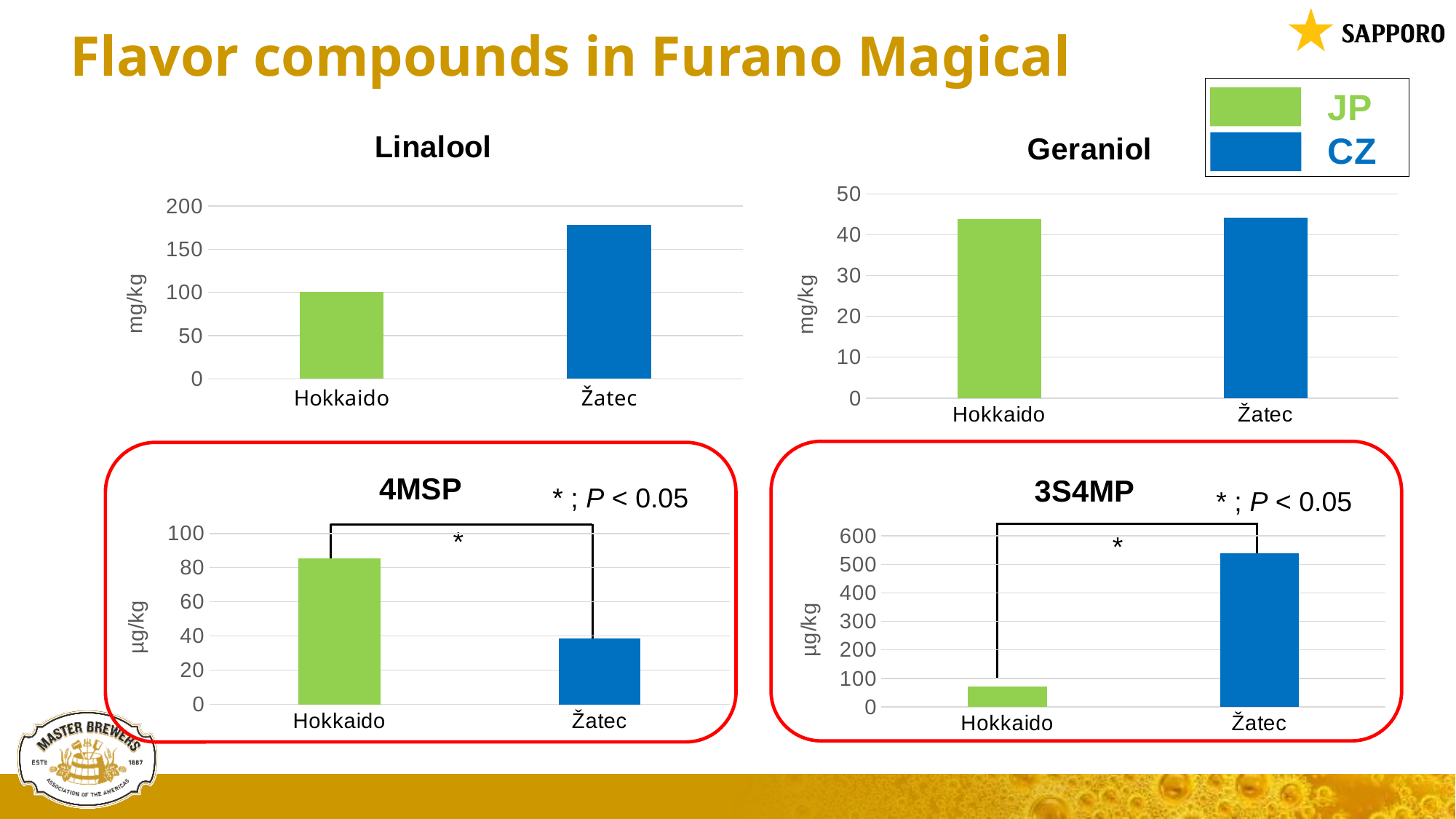
In the Linalool chart, which category has the higher value, Hokkaido or Žatec? Žatec In the Linalool chart, is the value for Žatec greater or less than 150? greater In the Geraniol chart, is the value for Hokkaido greater or less than 40? greater How many entries does the legend at the top right of the slide list? 2 In the 3S4MP chart, is the value for Žatec greater or less than 500? greater What kind of chart is the Linalool chart? bar chart How many categories are shown on the x axis of the Geraniol chart? 2 In the 3S4MP chart, which category has the lowest value? Hokkaido What unit is shown on the y axis of the 3S4MP chart? µg/kg In the 4MSP chart, which category has the highest value? Hokkaido